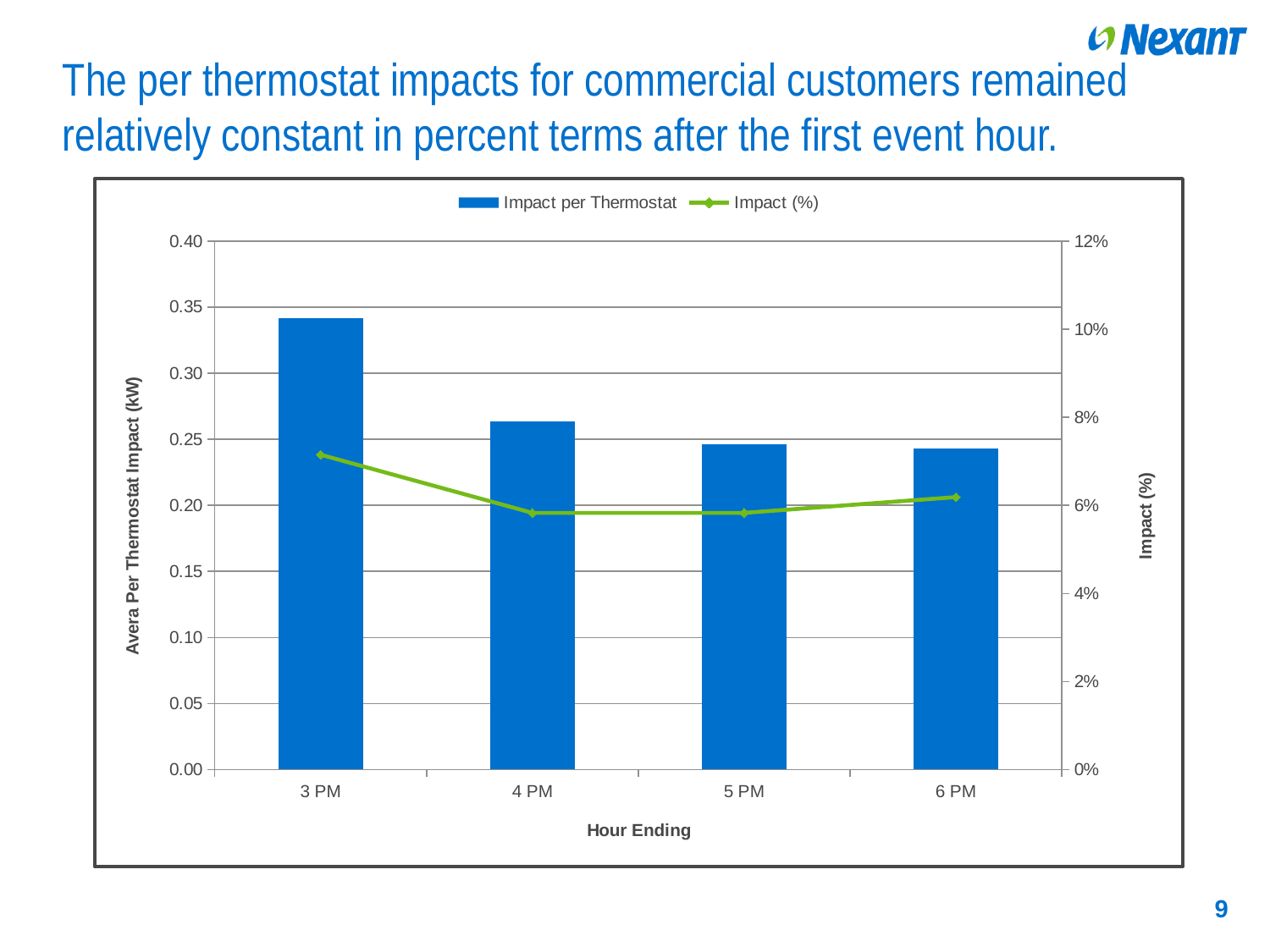
How many series does the legend list? 2 Which hour has the highest Impact per Thermostat bar? 3 PM How many hour categories are shown on the x axis? 4 Is the Impact per Thermostat value for 3 PM greater or less than 0.30? greater What is the title of the x axis? Hour Ending What kind of chart is this? A combined bar and line chart Which hour has the highest Impact (%) value? 3 PM Is the Impact (%) value for 4 PM greater or less than 6%? less Do the Impact per Thermostat bars rise or fall from 3 PM to 6 PM? fall Is the Impact (%) value for 3 PM greater or less than 6%? greater Which is larger, the Impact per Thermostat bar for 3 PM or for 4 PM? 3 PM